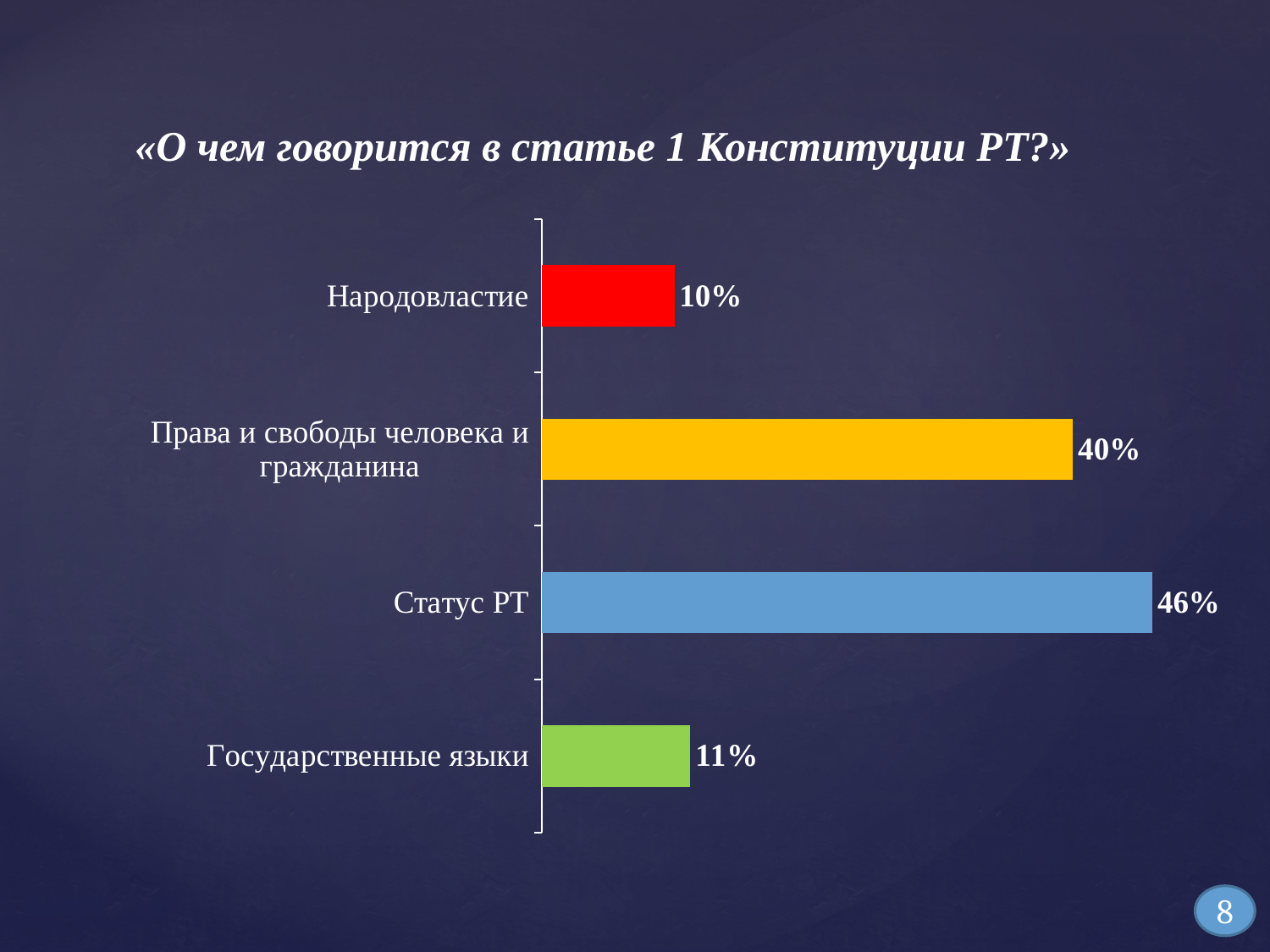
Which category has the lowest value? Народовластие What is the value for Государственные языки? 11% What kind of chart is shown on the slide? Bar chart What is the value for Народовластие? 10% What is the value for Статус РТ? 46% Which is larger, the value for Статус РТ or the value for Права и свободы человека и гражданина? Статус РТ What is the value for Права и свободы человека и гражданина? 40% What is the difference between the values for Государственные языки and Народовластие? 1% Which category has the highest value? Статус РТ What is the difference between the values for Статус РТ and Права и свободы человека и гражданина? 6% How many categories are shown in the chart? 4 What is the title of the slide above the chart? «О чем говорится в статье 1 Конституции РТ?»